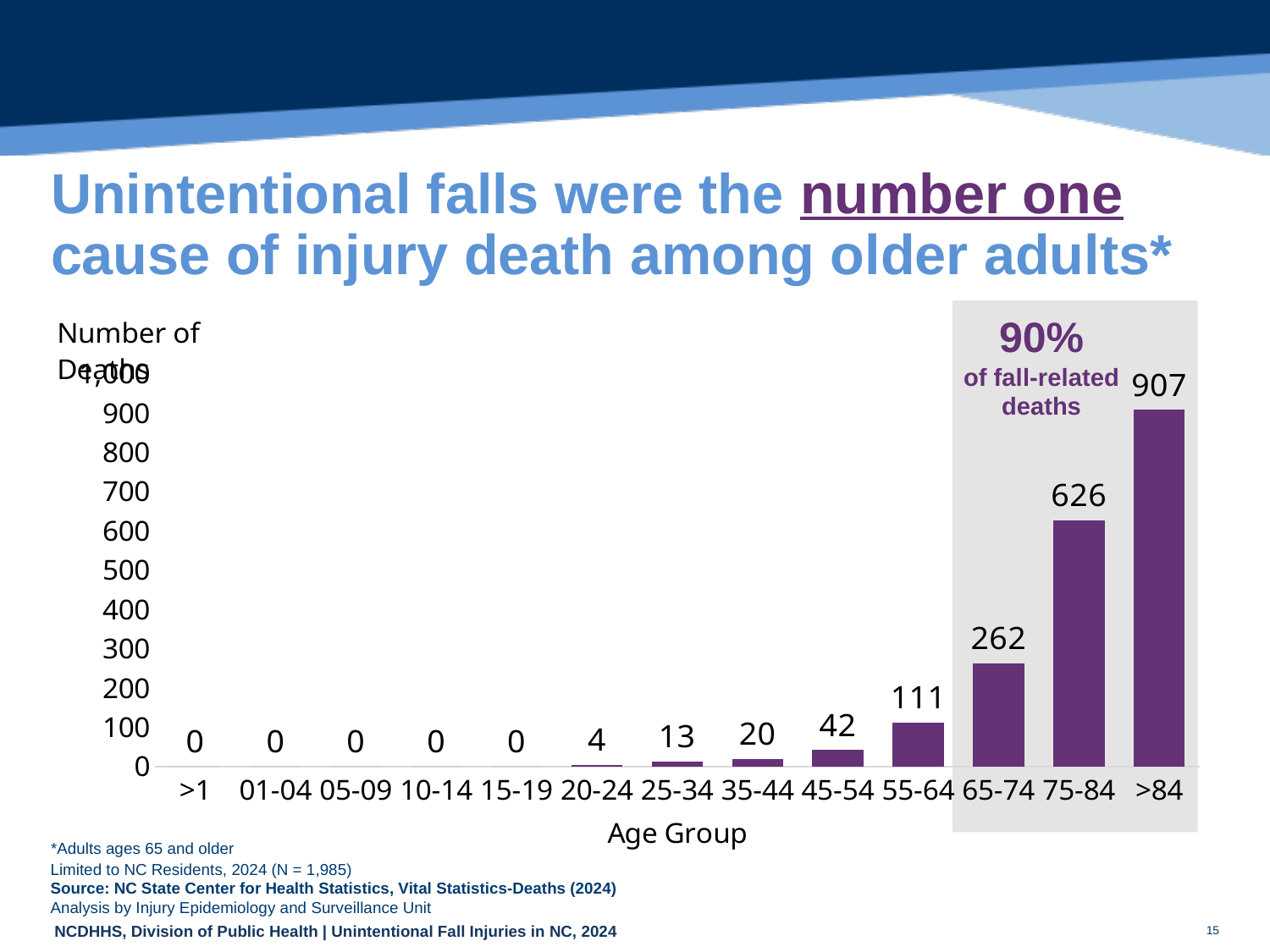
What is the difference in deaths between the 55-64 and 45-54 age groups? 69 What percentage of fall-related deaths is highlighted in the shaded area of the chart? 90% What is the number of deaths for the 65-74 age group? 262 How many age groups are shown on the x axis? 13 What is the number of deaths for the 45-54 age group? 42 Do the number of deaths rise or fall as age group increases from 20-24 to >84? Rise What is the difference in deaths between the >84 and 75-84 age groups? 281 Which age group has the highest number of deaths? >84 What is the number of deaths for the >84 age group? 907 How many age groups have 0 deaths? 5 Which age group has more deaths, 35-44 or 25-34? 35-44 What kind of chart is shown on the slide? Bar chart